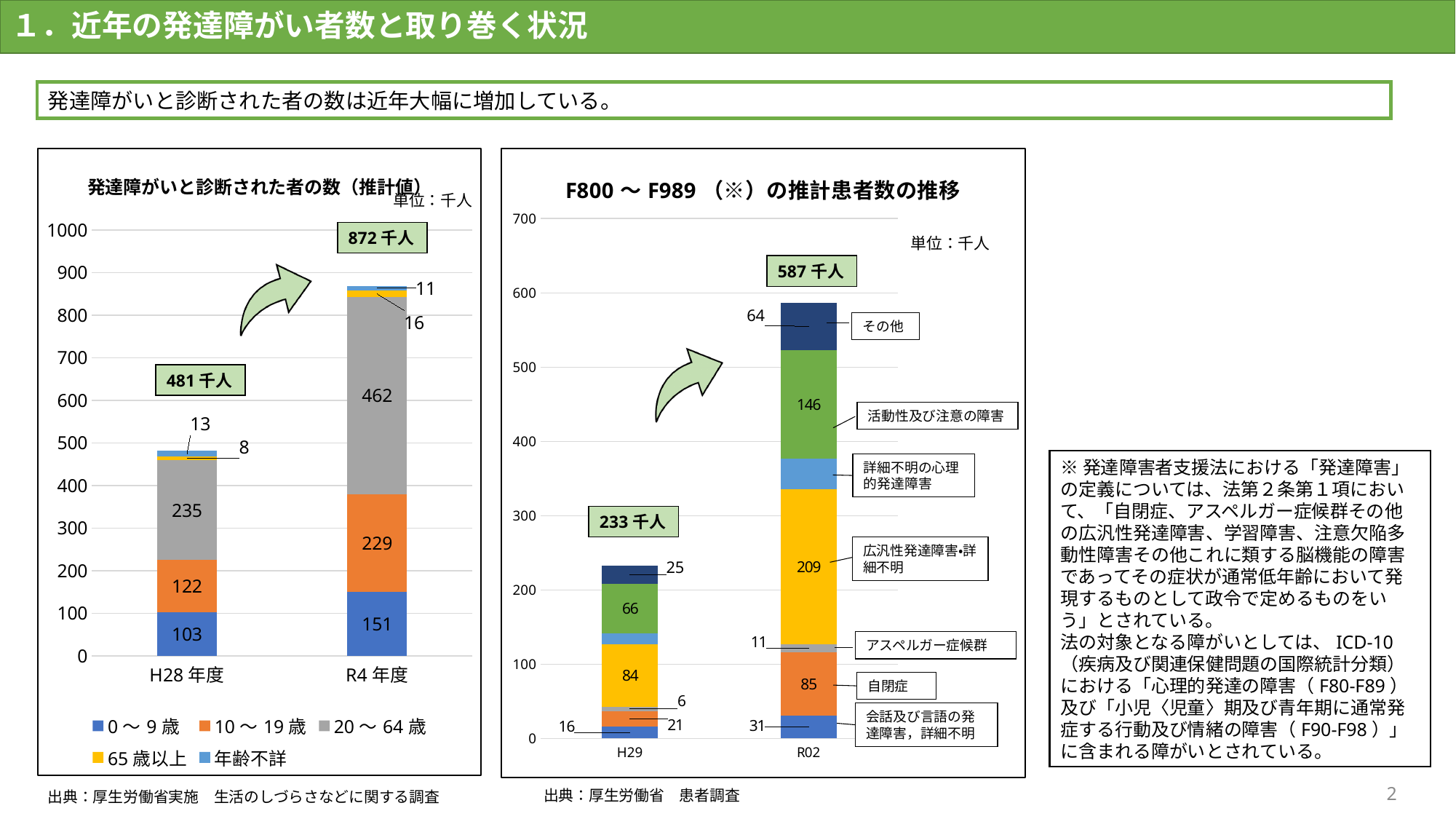
In the left chart (発達障がいと診断された者の数（推計値）), what is the total for the R4年度 bar? 872千人 In the right chart (F800～F989（※）の推計患者数の推移), is the total for H29 greater or less than 300? less In the left chart (発達障がいと診断された者の数（推計値）), what is the value for 0～9歳 in H28年度? 103 In the left chart (発達障がいと診断された者の数（推計値）), what is the difference between the 10～19歳 values for R4年度 and H28年度? 107 In the right chart (F800～F989（※）の推計患者数の推移), which is larger in R02: 広汎性発達障害・詳細不明 or 活動性及び注意の障害? 広汎性発達障害・詳細不明 What kind of chart is the left chart (発達障がいと診断された者の数（推計値）)? Stacked bar chart In the left chart (発達障がいと診断された者の数（推計値）), how many series does the legend list? 5 In the right chart (F800～F989（※）の推計患者数の推移), what is the total for the R02 bar? 587千人 In the left chart (発達障がいと診断された者の数（推計値）), what is the value for 20～64歳 in R4年度? 462 In the left chart (発達障がいと診断された者の数（推計値）), which age group has the largest value in H28年度? 20～64歳 In the right chart (F800～F989（※）の推計患者数の推移), what is the value for 活動性及び注意の障害 in H29? 66 In the right chart (F800～F989（※）の推計患者数の推移), what is the value for 自閉症 in R02? 85